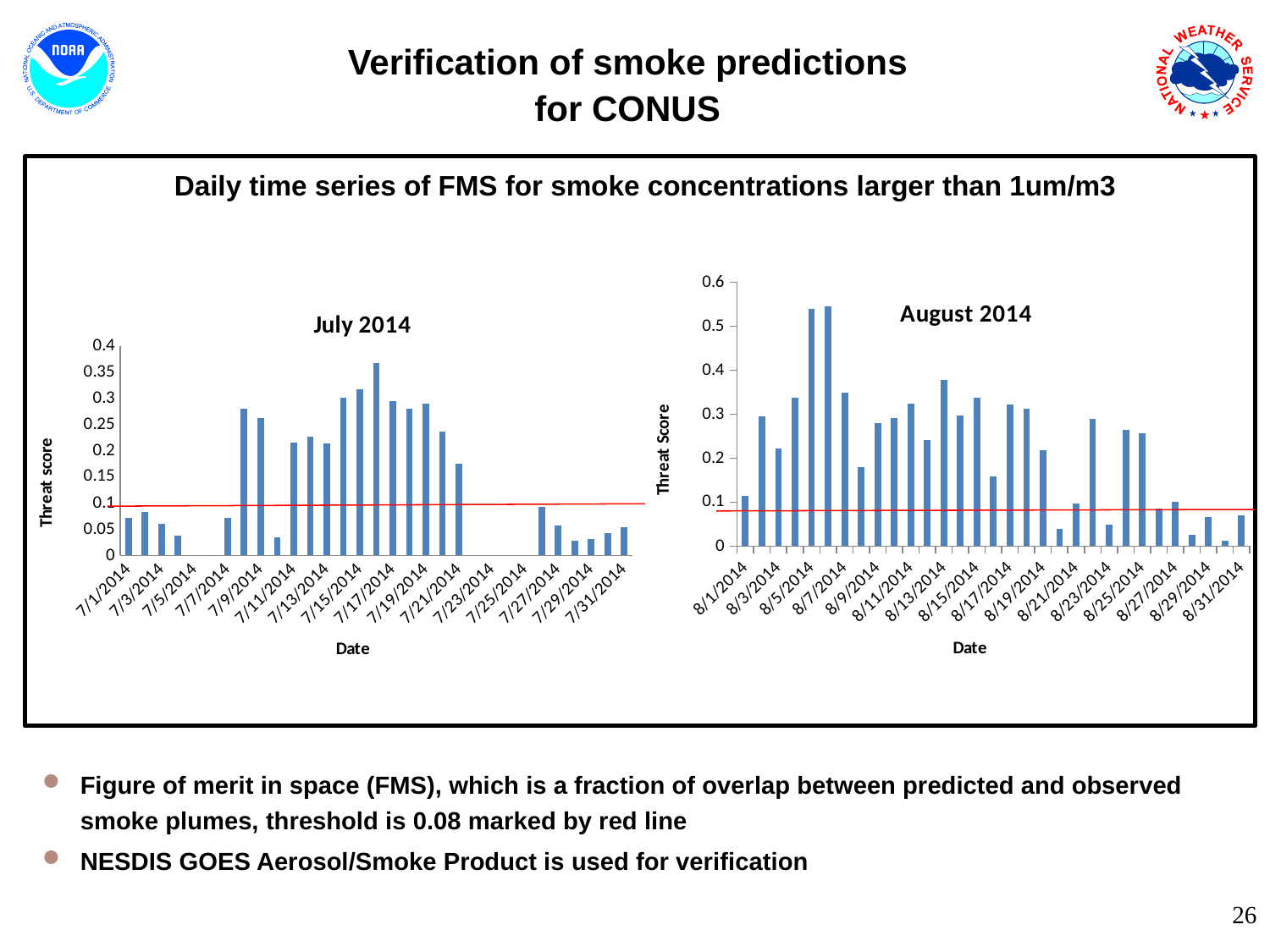
In the August 2014 chart, is the value for 8/1/2014 greater or less than 0.2? less What is the title of the y axis on the July 2014 chart? Threat score In the August 2014 chart, which is larger, the value for 8/1/2014 or the value for 8/31/2014? 8/1/2014 In the July 2014 chart, is the value for 7/1/2014 greater or less than 0.1? less What type of chart is the August 2014 chart? bar chart What type of chart is the July 2014 chart? bar chart What is the highest tick value on the y axis of the August 2014 chart? 0.6 In the August 2014 chart, is the value for 8/31/2014 greater or less than 0.1? less